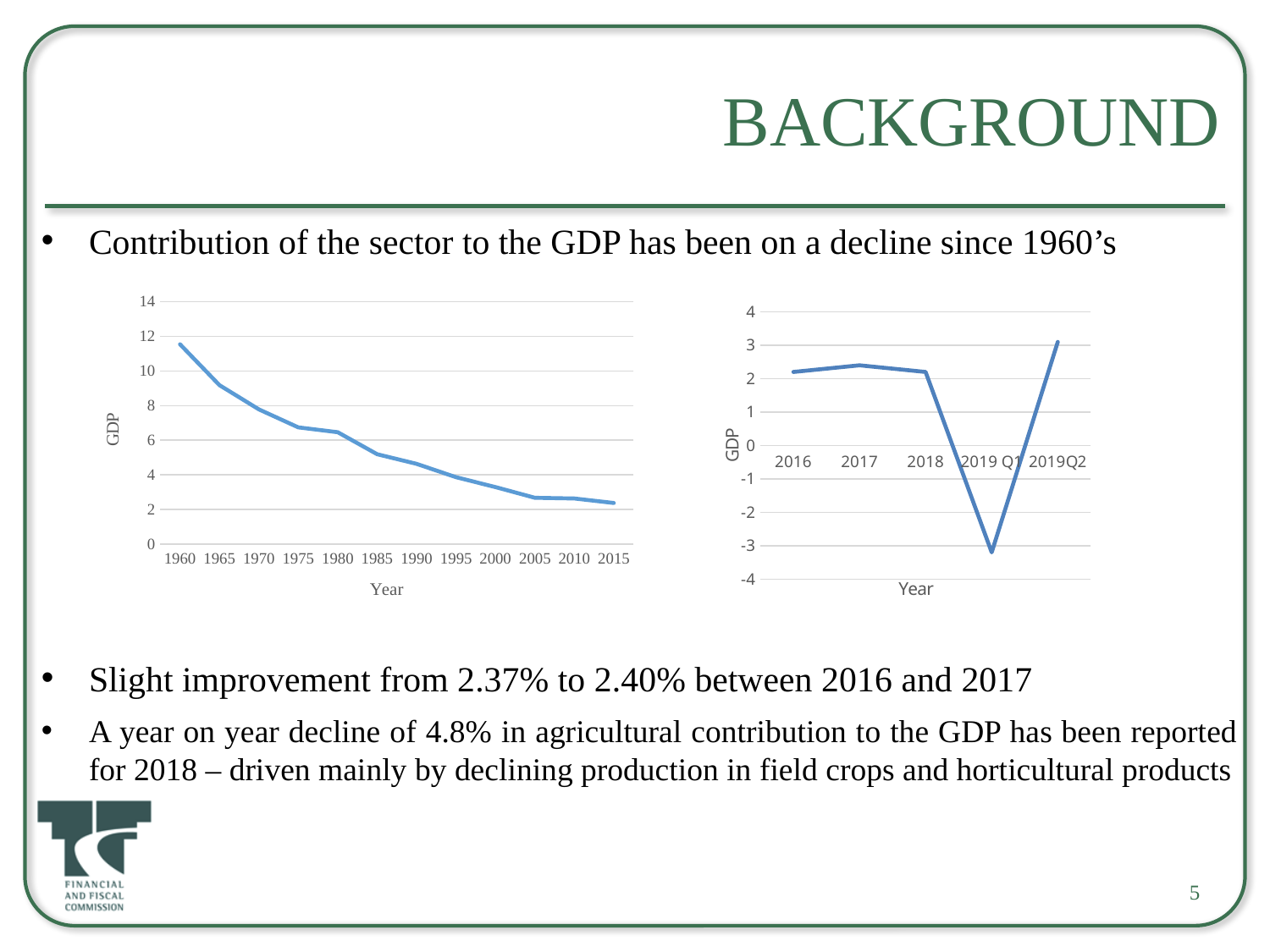
What kind of chart is the chart on the left of the slide? line chart What kind of chart is the chart on the right of the slide? line chart In the chart on the right, which period has the lowest GDP value? 2019 Q1 In the chart on the left, do the GDP values rise or fall from 1960 to 2015? fall In the chart on the left, which year has the lowest GDP value? 2015 In the chart on the left, how many years are labelled on the x axis? 12 In the chart on the right, which is larger, the value for 2017 or the value for 2019 Q1? 2017 In the chart on the right, how many periods are labelled on the x axis? 5 In the chart on the left, is the value for 1960 greater or less than 10? greater In the chart on the right, is the value for 2019 Q1 greater or less than -2? less In the chart on the left, is the value for 2015 greater or less than 4? less In the chart on the left, which year has the highest GDP value? 1960